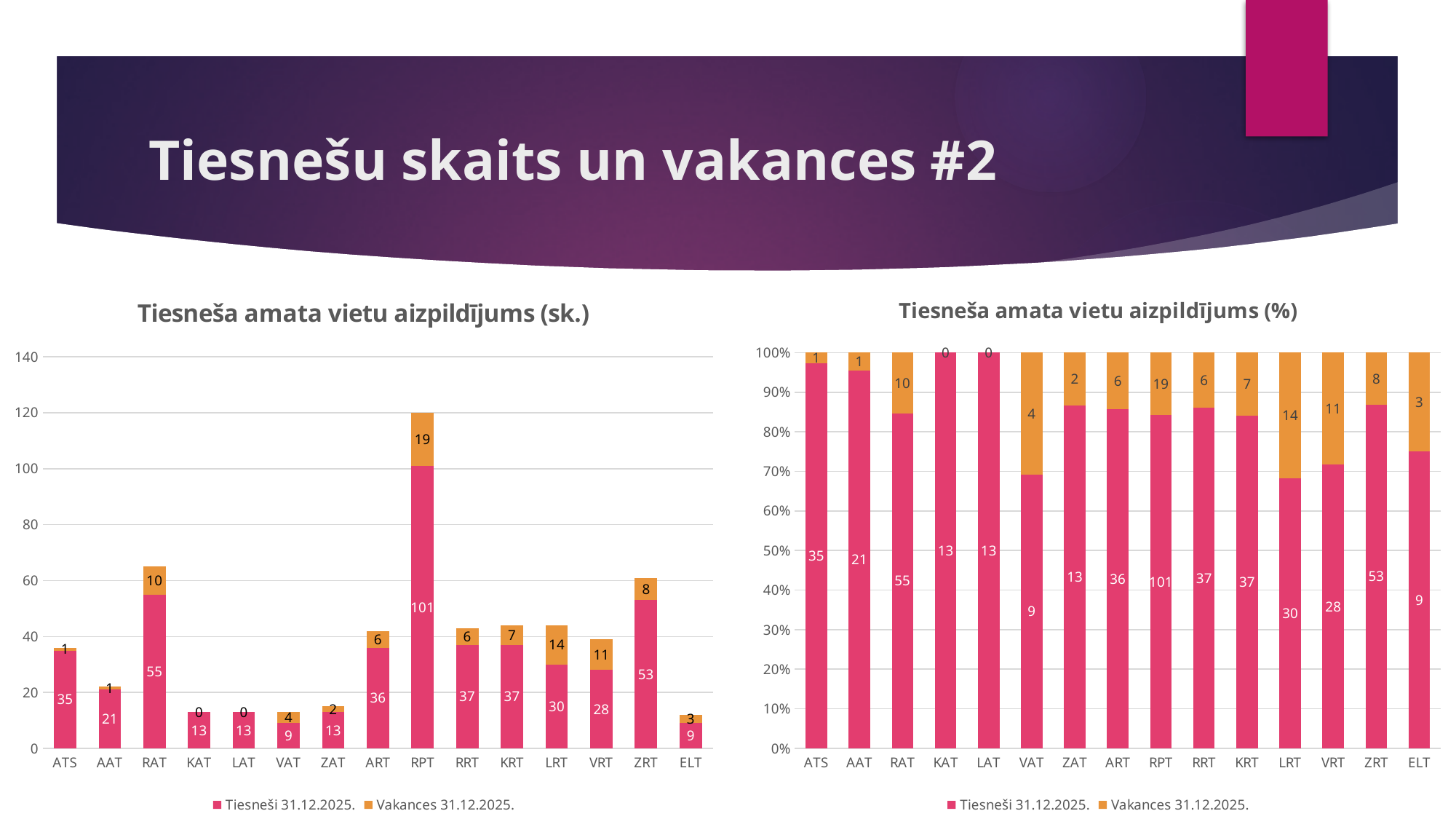
In the chart titled "Tiesneša amata vietu aizpildījums (sk.)", what is the total of the stacked bar for RAT? 65 In the chart titled "Tiesneša amata vietu aizpildījums (sk.)", which category has the highest Tiesneši 31.12.2025. value? RPT In the chart titled "Tiesneša amata vietu aizpildījums (sk.)", which category has the highest Vakances 31.12.2025. value? RPT In the chart titled "Tiesneša amata vietu aizpildījums (%)", is the Tiesneši 31.12.2025. share for VAT greater or less than 80%? less In the chart titled "Tiesneša amata vietu aizpildījums (sk.)", which is larger: the Vakances 31.12.2025. value for VRT or for ZRT? VRT In the chart titled "Tiesneša amata vietu aizpildījums (%)", how many series does the legend list? 2 In the chart titled "Tiesneša amata vietu aizpildījums (sk.)", what is the value of Vakances 31.12.2025. for KAT? 0 In the chart titled "Tiesneša amata vietu aizpildījums (sk.)", what is the value of Vakances 31.12.2025. for LRT? 14 In the chart titled "Tiesneša amata vietu aizpildījums (sk.)", what is the value of Tiesneši 31.12.2025. for RPT? 101 In the chart titled "Tiesneša amata vietu aizpildījums (sk.)", what is the difference between the Tiesneši 31.12.2025. values for ZRT and VRT? 25 What kind of chart is the chart titled "Tiesneša amata vietu aizpildījums (%)"? Stacked bar chart In the chart titled "Tiesneša amata vietu aizpildījums (sk.)", how many categories are shown on the x axis? 15